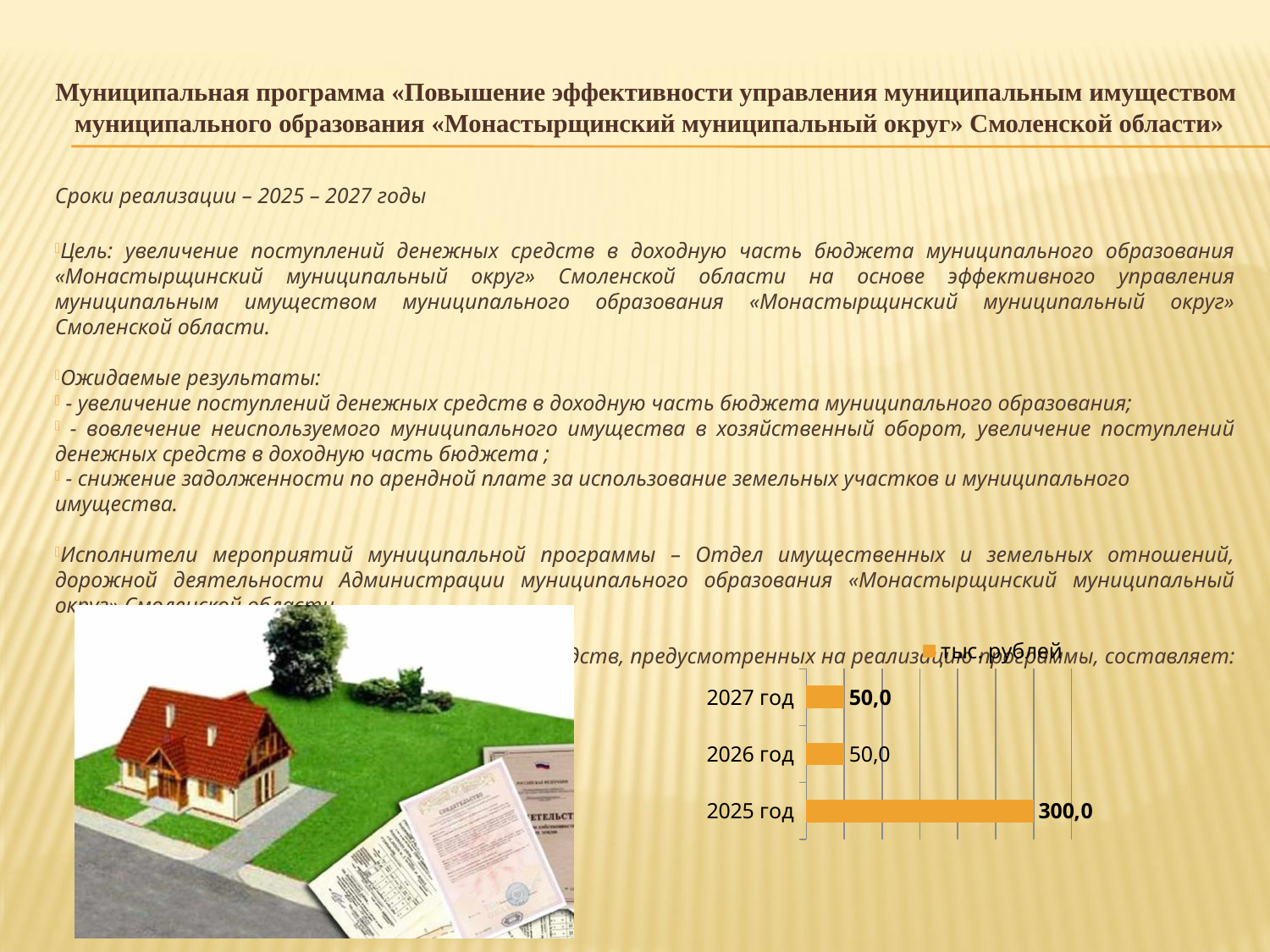
Which is larger, the value for 2025 год or the value for 2027 год? 2025 год What is the difference between the values for 2025 год and 2027 год? 250,0 What is the value for 2027 год? 50,0 What is the legend entry of the chart? тыс. рублей How many categories are shown in the chart? 3 What is the value for 2026 год? 50,0 What is the total of the values for 2025 год, 2026 год and 2027 год? 400,0 Which year has the highest value? 2025 год What is the difference between the values for 2025 год and 2026 год? 250,0 What is the value for 2025 год? 300,0 How many series does the legend list? 1 What kind of chart is shown on the slide? bar chart